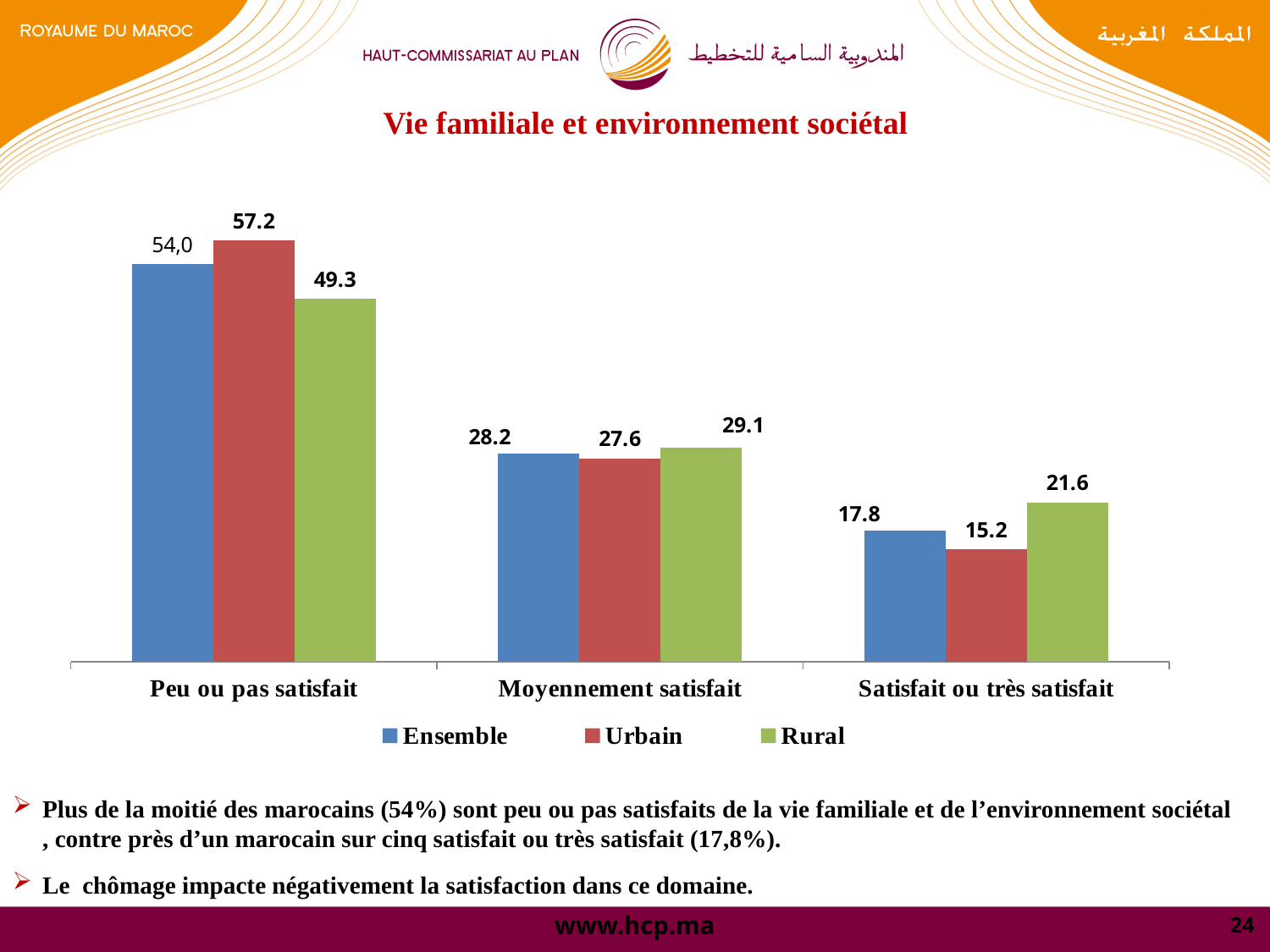
How many series does the legend list? 3 What is the Ensemble value for "Moyennement satisfait"? 28.2 Which category has the highest Ensemble value? Peu ou pas satisfait Which category has the lowest Urbain value? Satisfait ou très satisfait What kind of chart is shown on the slide? Bar chart What is the difference between the Rural and Urbain values for "Satisfait ou très satisfait"? 6.4 How many categories are shown on the x axis? 3 What is the Rural value for "Satisfait ou très satisfait"? 21.6 What is the Urbain value for "Peu ou pas satisfait"? 57.2 Do the Ensemble values rise or fall from left to right across the categories? Fall What is the difference between the Urbain and Rural values for "Peu ou pas satisfait"? 7.9 For "Moyennement satisfait", which is larger: the Urbain value or the Rural value? Rural